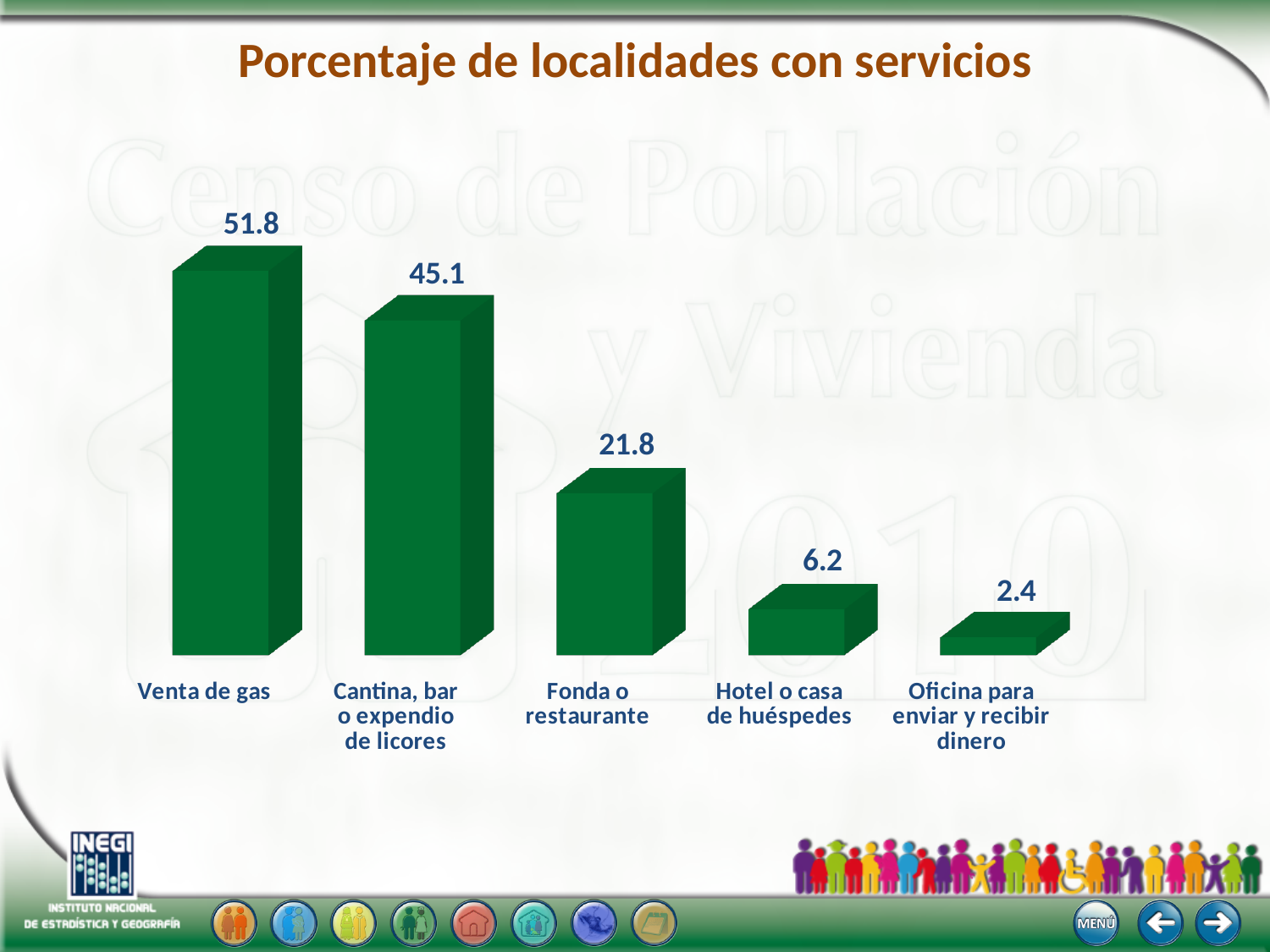
Which category has the highest value? Venta de gas Do the values rise or fall from left to right across the categories? Fall What is the value for Venta de gas? 51.8 What is the difference between the values for Venta de gas and Cantina, bar o expendio de licores? 6.7 Which category has the lowest value? Oficina para enviar y recibir dinero What is the value for Fonda o restaurante? 21.8 What is the title of the chart? Porcentaje de localidades con servicios What is the difference between the values for Fonda o restaurante and Hotel o casa de huéspedes? 15.6 How many categories are shown in the chart? 5 Which is larger, the value for Hotel o casa de huéspedes or the value for Oficina para enviar y recibir dinero? Hotel o casa de huéspedes What is the value for Oficina para enviar y recibir dinero? 2.4 What kind of chart is shown on the slide? Bar chart